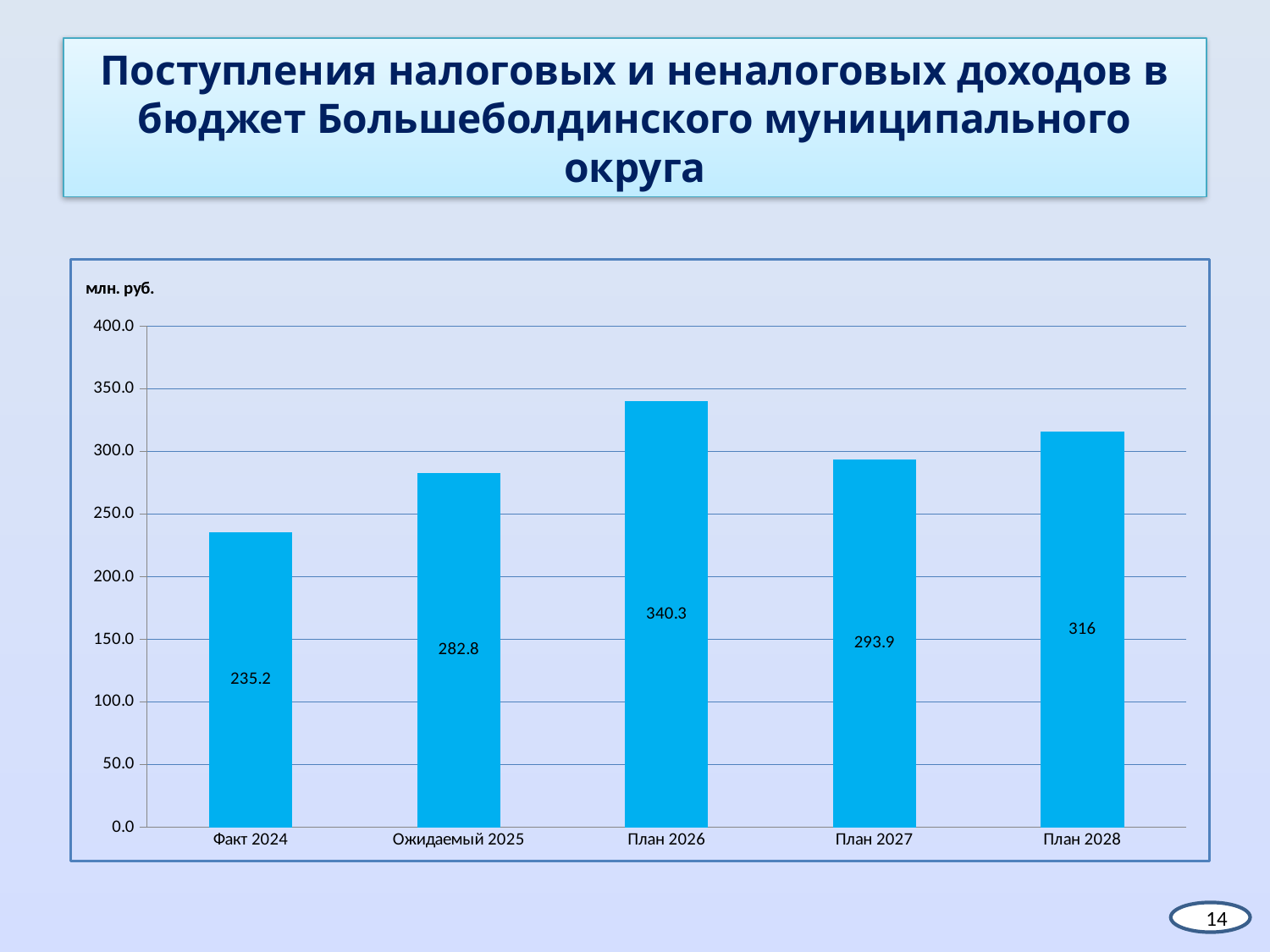
What is the difference between the values for Ожидаемый 2025 and Факт 2024? 47.6 What is the value for Факт 2024? 235.2 What kind of chart is shown on the slide? bar chart What is the difference between the values for План 2026 and План 2027? 46.4 Which category has the lowest value? Факт 2024 What is the value for План 2026? 340.3 How many categories are shown on the x axis? 5 Which is larger, the value for План 2028 or the value for План 2027? План 2028 What is the value for План 2028? 316 Which category has the highest value? План 2026 Is the value for Ожидаемый 2025 greater or less than 250.0? greater What unit is indicated at the top of the chart's vertical axis? млн. руб.